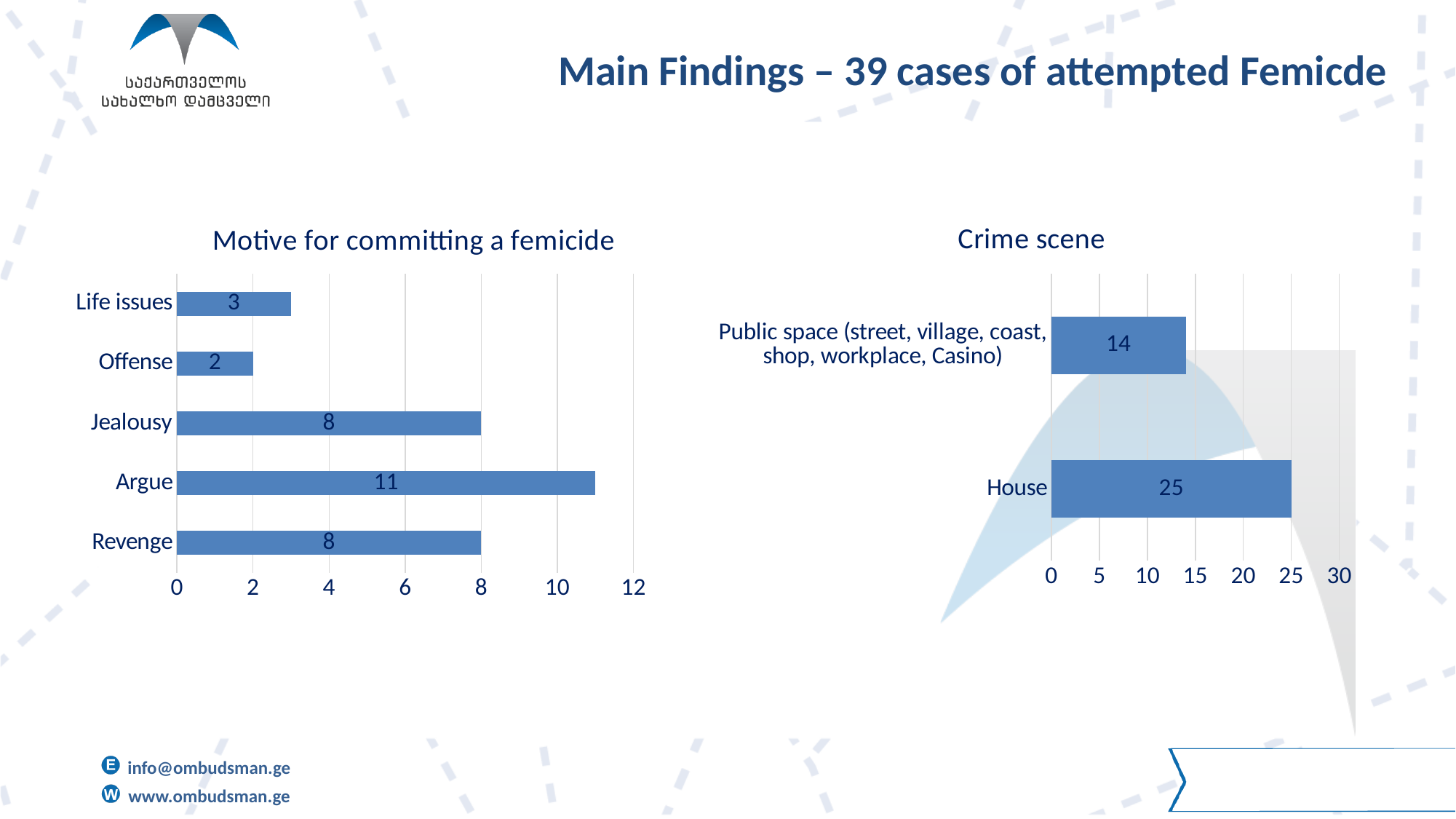
In the 'Motive for committing a femicide' chart, is the value for Argue greater or less than 10? greater In the 'Motive for committing a femicide' chart, how many motive categories are shown? 5 In the 'Motive for committing a femicide' chart, what is the value for Argue? 11 In the 'Crime scene' chart, what is the difference between the values for House and Public space? 11 In the 'Motive for committing a femicide' chart, which motive has the lowest value? Offense In the 'Motive for committing a femicide' chart, what is the difference between the values for Argue and Jealousy? 3 In the 'Crime scene' chart, which category is larger, House or Public space? House In the 'Motive for committing a femicide' chart, what is the value for Life issues? 3 In the 'Crime scene' chart, what is the value for House? 25 What type of chart is the 'Crime scene' chart? Bar chart In the 'Crime scene' chart, what is the value for Public space (street, village, coast, shop, workplace, Casino)? 14 In the 'Motive for committing a femicide' chart, which motive has the highest value? Argue